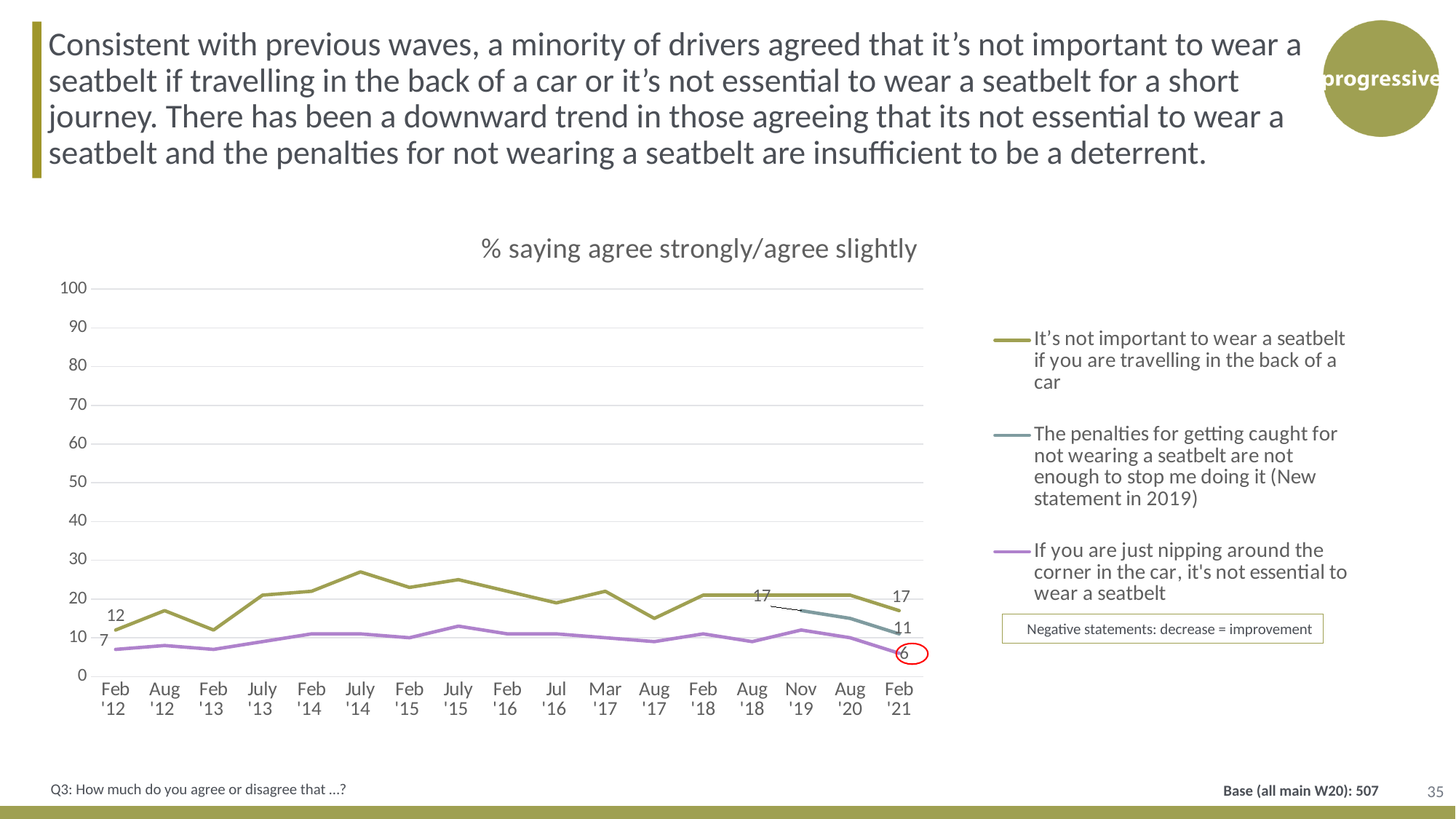
What is the value for 'It's not important to wear a seatbelt if you are travelling in the back of a car' in Feb '12? 12 What is the title of the chart? % saying agree strongly/agree slightly Is the value for 'It's not important to wear a seatbelt if you are travelling in the back of a car' in July '14 greater or less than 20? greater What is the value for 'If you are just nipping around the corner in the car, it's not essential to wear a seatbelt' in Feb '21? 6 By how much did the value for 'The penalties for getting caught for not wearing a seatbelt are not enough to stop me doing it' fall between Nov '19 and Feb '21? 6 What is the value for 'The penalties for getting caught for not wearing a seatbelt are not enough to stop me doing it' in Feb '21? 11 What is the value for 'The penalties for getting caught for not wearing a seatbelt are not enough to stop me doing it' in Nov '19? 17 How many time points are shown along the x axis? 17 In Feb '21, what is the difference between the 'not important to wear a seatbelt in the back of a car' value and the 'nipping around the corner' value? 11 How many series does the legend list? 3 What is the value for 'It's not important to wear a seatbelt if you are travelling in the back of a car' in Feb '21? 17 What kind of chart is shown on the slide? Line chart